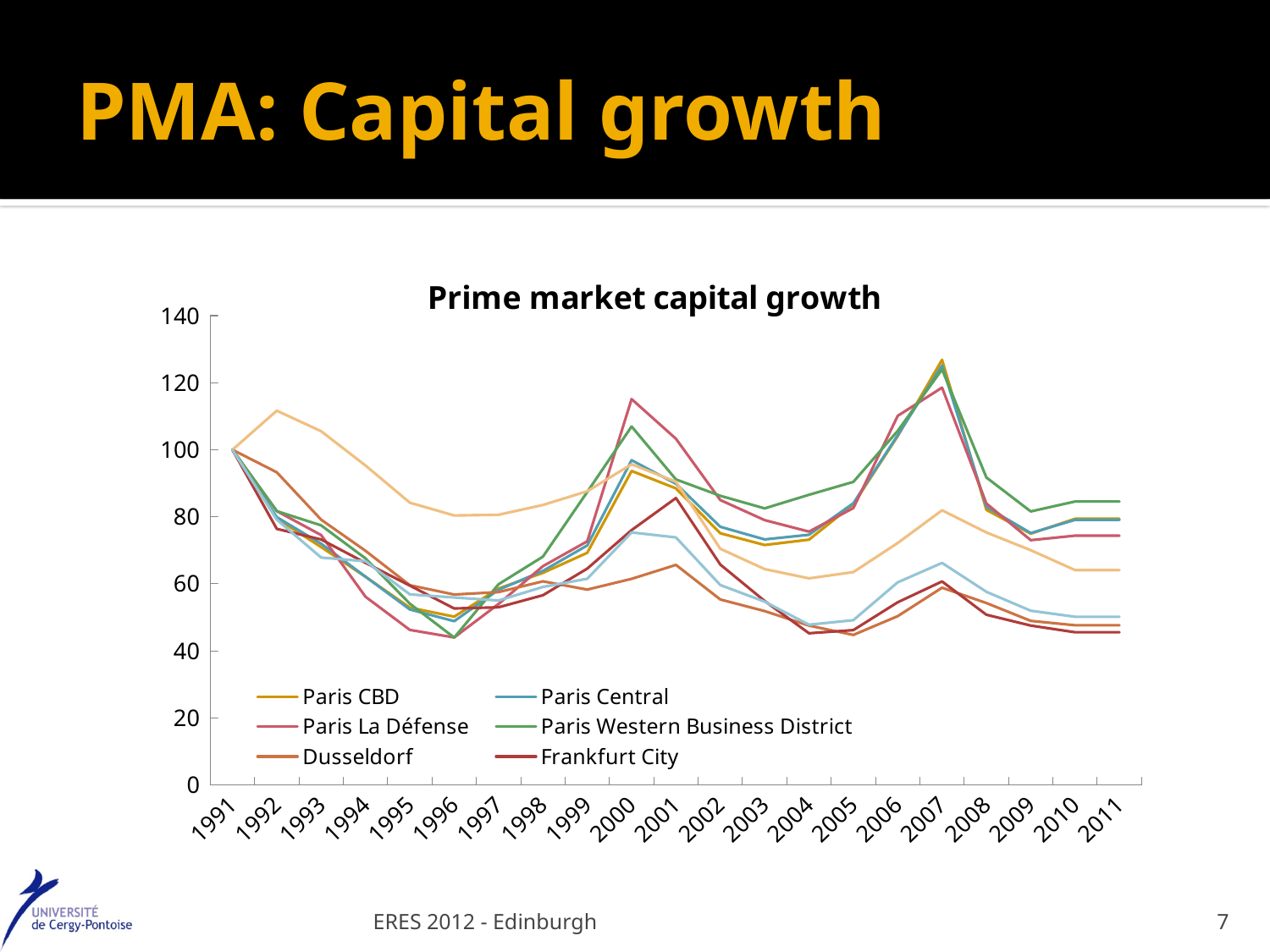
Does the value for Frankfurt City rise or fall from 2004 to 2007? rise Is the value for Paris CBD in 2007 greater or less than 120? greater In 2011, which is larger: Paris Western Business District or Frankfurt City? Paris Western Business District What type of chart is shown on the slide? Line chart In 2007, which is larger: Paris La Défense or Dusseldorf? Paris La Défense How many years are shown on the x axis? 21 Is the value for Frankfurt City in 2011 greater or less than 60? less How many series does the legend list? 6 Is the value for Paris La Défense in 2000 greater or less than 100? greater What is the value for Paris CBD in 1991? 100 Which series has the highest value in 2000? Paris La Défense What is the title of the chart? Prime market capital growth